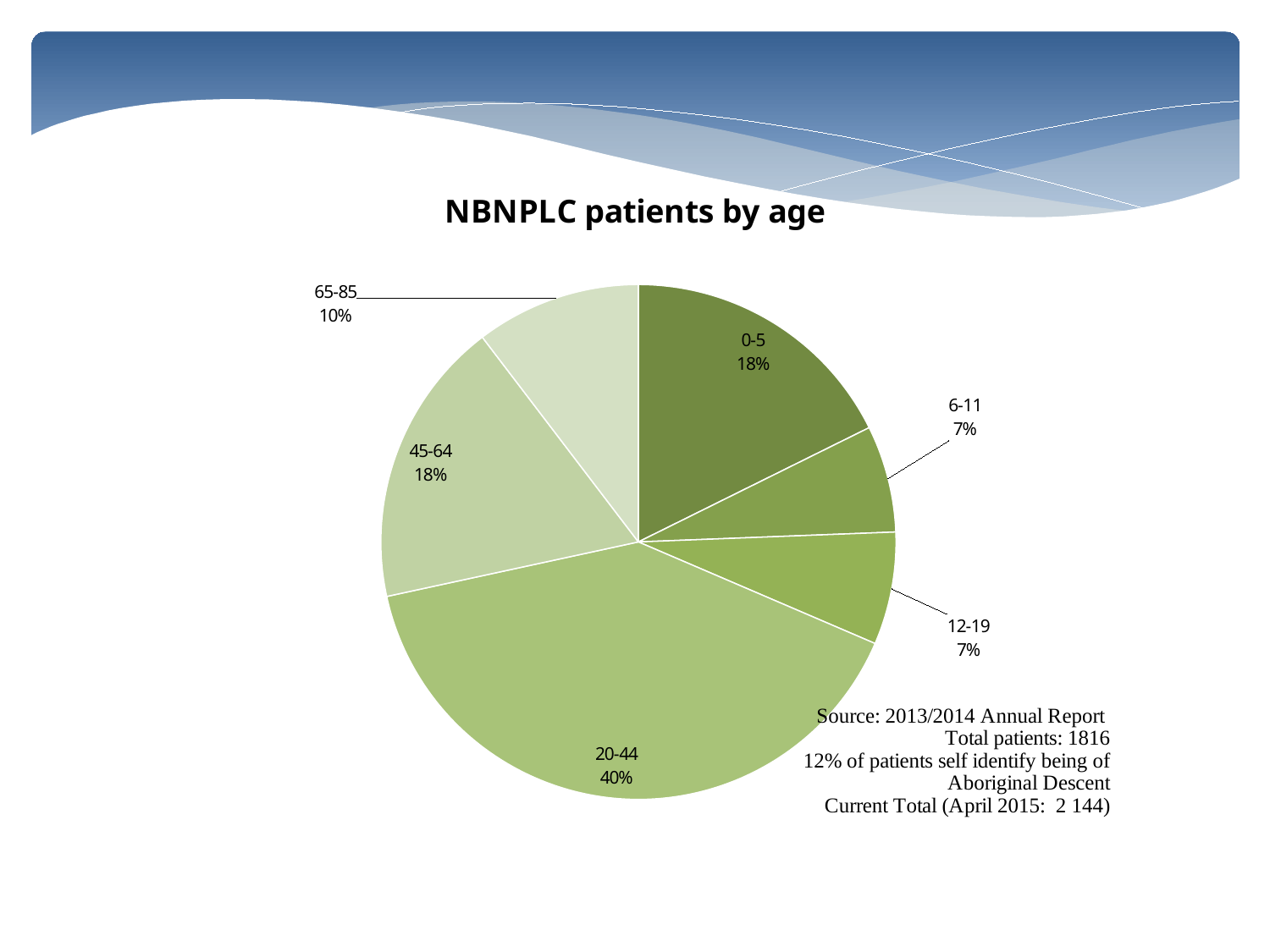
What percentage of patients are in the 65-85 age group? 10% How many age groups are shown in the pie chart? 6 What is the difference in percentage points between the 20-44 group and the 45-64 group? 22 What is the difference in percentage points between the 45-64 group and the 65-85 group? 8 Which age group has the largest share of patients? 20-44 What is the title of the chart? NBNPLC patients by age What percentage of patients are aged 6-11? 7% What share of NBNPLC patients are aged 20-44? 40% What kind of chart is shown on the slide? pie chart Which is larger, the share for 65-85 or the share for 12-19? 65-85 What is the combined share of the 0-5 and 6-11 age groups? 25% What percentage of patients are in the 0-5 age group? 18%